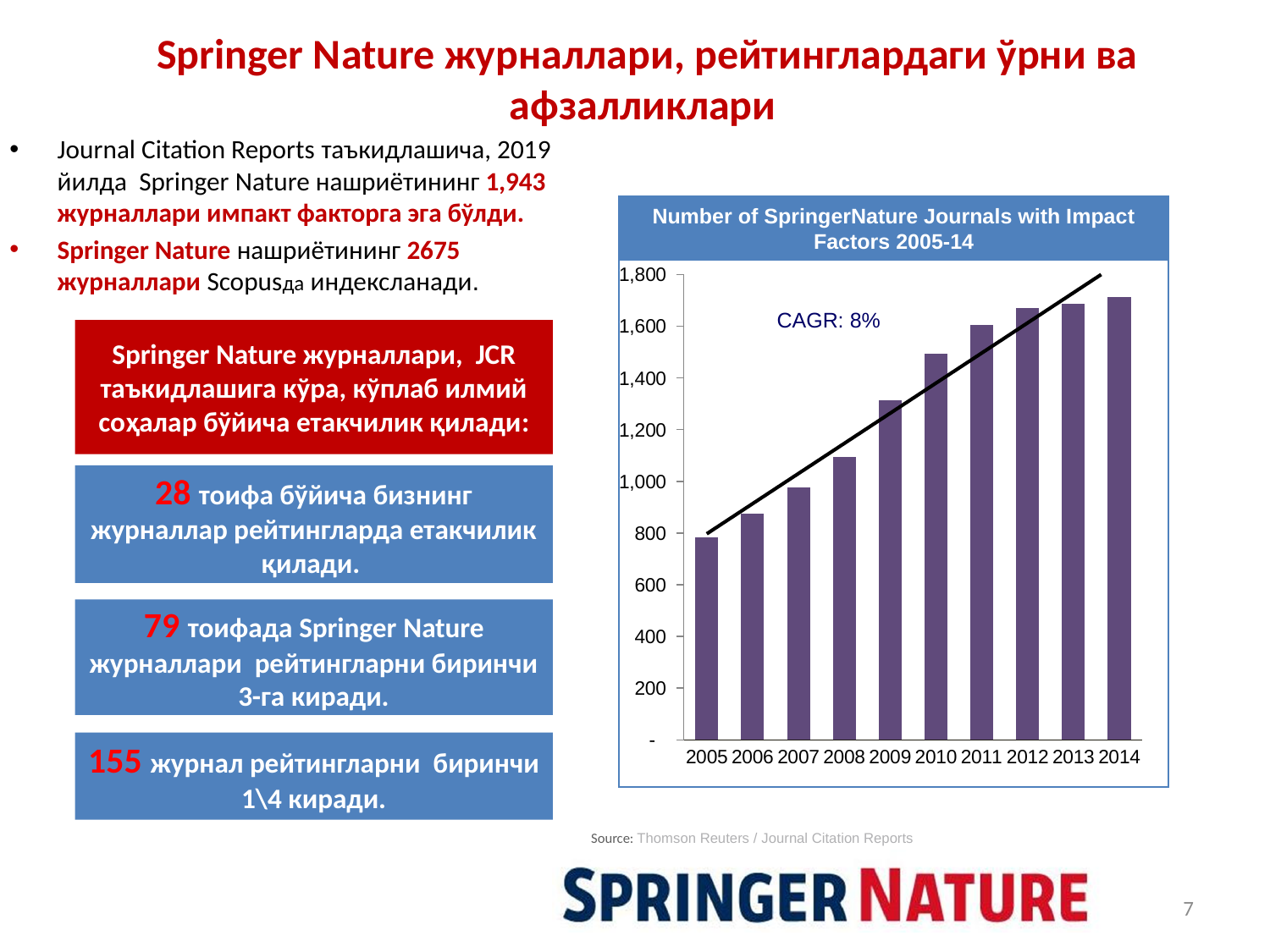
What kind of chart is shown on the slide? bar chart How many years are plotted on the x axis of the chart? 10 Which year has the larger value, 2006 or 2010? 2010 What CAGR is annotated on the chart? 8% Is the value for 2005 greater or less than 1,000? less Is the value for 2011 greater or less than 1,400? greater What is the title of the chart? Number of SpringerNature Journals with Impact Factors 2005-14 Is the value for 2014 greater or less than 1,600? greater Which year has the lowest number of journals with impact factors in the chart? 2005 Do the values in the chart rise or fall from 2005 to 2014? rise